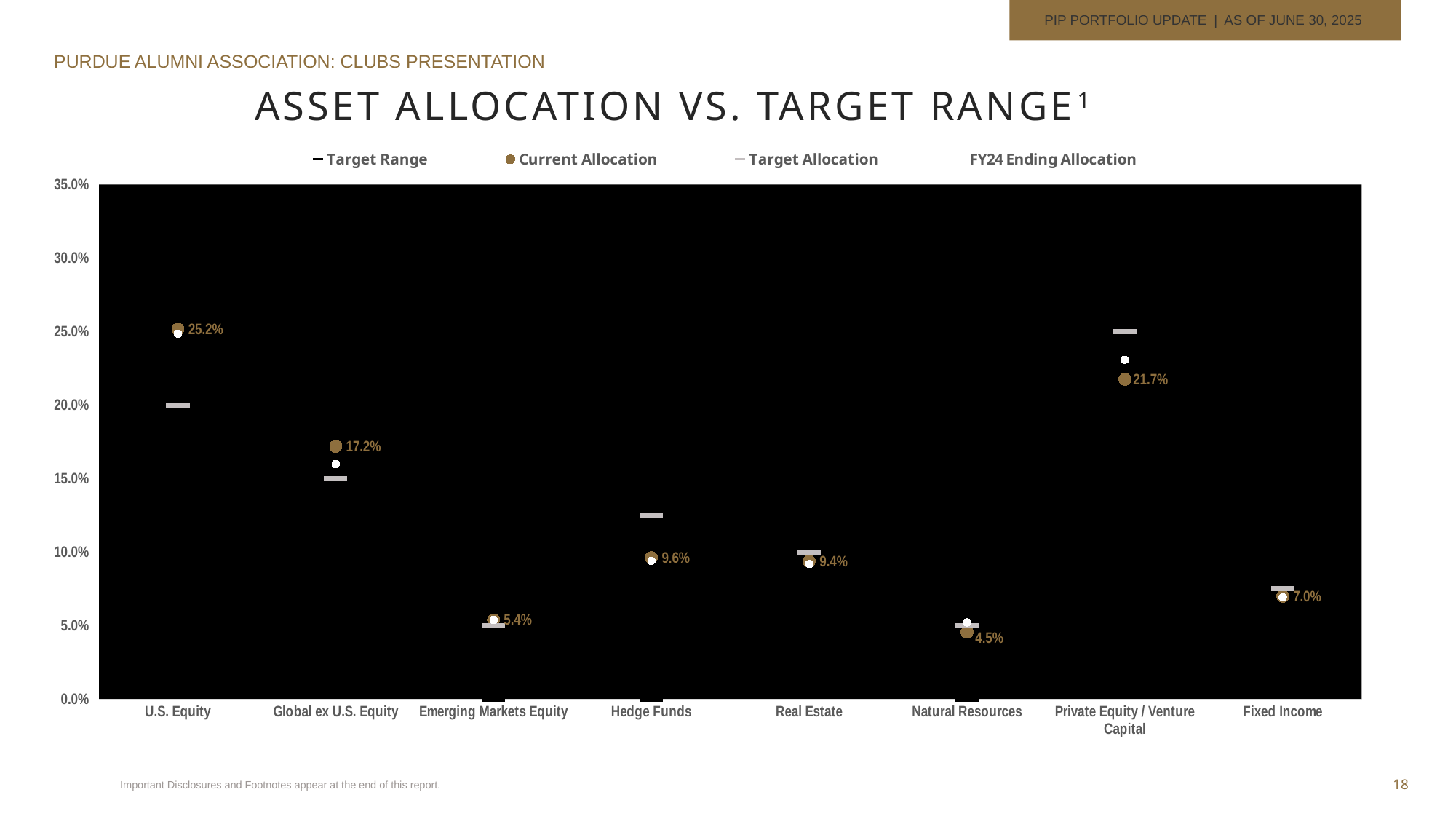
What is the Current Allocation for Private Equity / Venture Capital? 21.7% What is the Current Allocation for U.S. Equity? 25.2% Is the Target Allocation for Hedge Funds greater or less than 10.0%? greater Which asset class has the lowest Current Allocation? Natural Resources Which asset class has the highest Current Allocation? U.S. Equity What is the Current Allocation for Natural Resources? 4.5% What is the Current Allocation for Fixed Income? 7.0% Which has a larger Current Allocation, Global ex U.S. Equity or Emerging Markets Equity? Global ex U.S. Equity What is the title of the chart? Asset Allocation vs. Target Range How many asset classes are shown on the x axis? 8 What is the difference between the Current Allocation for U.S. Equity and for Private Equity / Venture Capital? 3.5 percentage points How many series does the legend list? 4